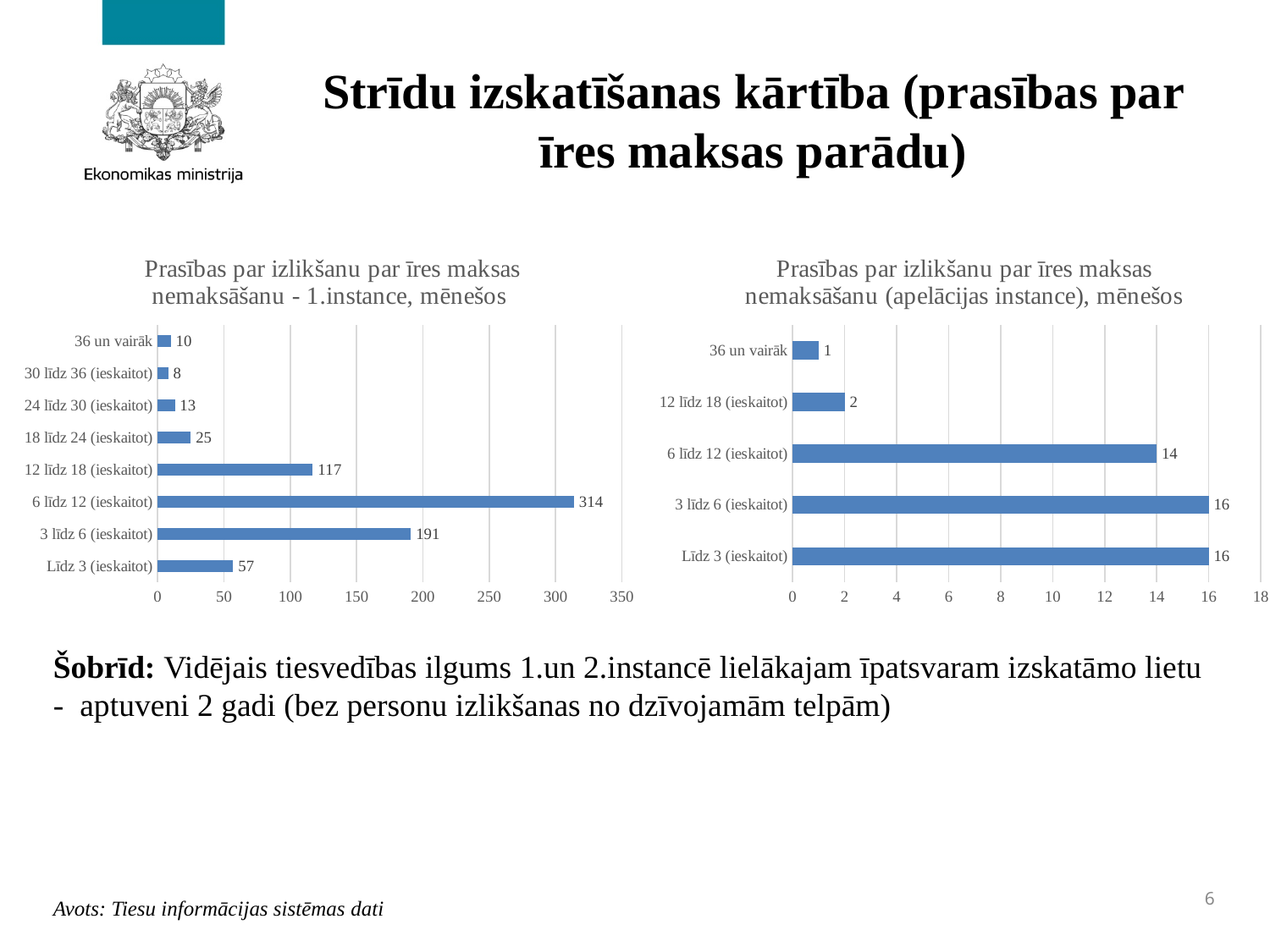
In the right chart (apelācijas instance), which is larger: the value for '12 līdz 18 (ieskaitot)' or '6 līdz 12 (ieskaitot)'? 6 līdz 12 (ieskaitot) In the right chart (apelācijas instance), what is the value for '6 līdz 12 (ieskaitot)'? 14 In the left chart (1.instance), what is the difference between the values for '6 līdz 12 (ieskaitot)' and '3 līdz 6 (ieskaitot)'? 123 In the left chart (1.instance), which category has the highest value? 6 līdz 12 (ieskaitot) In the left chart (1.instance), which category has the lowest value? 30 līdz 36 (ieskaitot) In the left chart (1.instance), how many categories are shown? 8 In the left chart (1.instance), what is the value for 'Līdz 3 (ieskaitot)'? 57 In the left chart (1.instance), is the value for '12 līdz 18 (ieskaitot)' greater or less than 100? greater In the right chart (apelācijas instance), how many categories are shown? 5 In the left chart (1.instance), what is the value for '6 līdz 12 (ieskaitot)'? 314 In the right chart (apelācijas instance), which category has the lowest value? 36 un vairāk What type of chart is the left chart (1.instance)? Bar chart